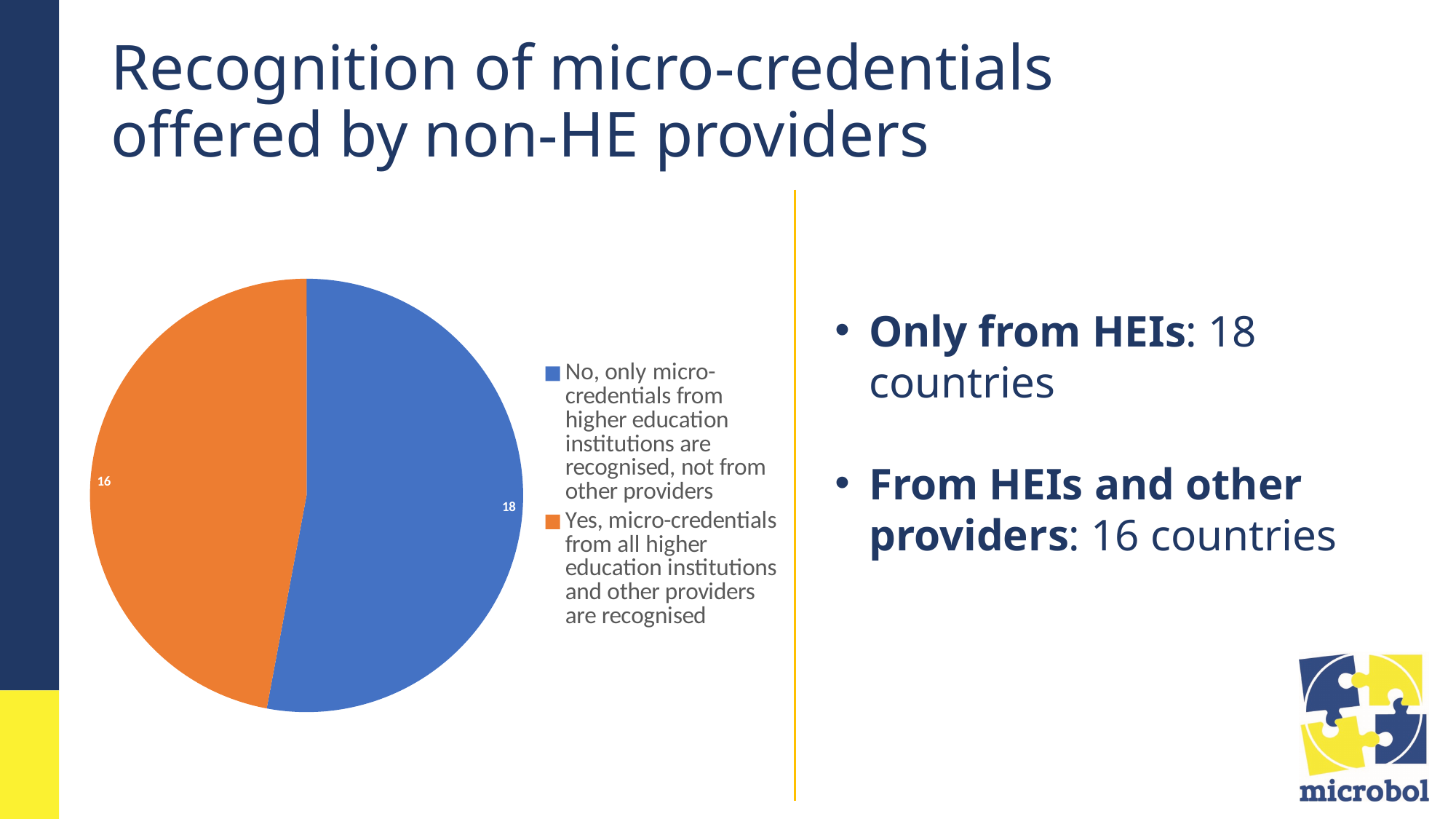
What type of chart is shown on the slide? pie chart How many slices does the pie chart have? 2 What is the value of the slice for 'Yes, micro-credentials from all higher education institutions and other providers are recognised'? 16 What is the total of the two slices in the pie chart? 34 How many entries does the pie chart legend list? 2 What colour is the slice for 'Yes, micro-credentials from all higher education institutions and other providers are recognised'? orange Which slice of the pie chart is the smallest? Yes, micro-credentials from all higher education institutions and other providers are recognised Which is larger: the 'No' slice or the 'Yes' slice? the 'No' slice Which slice of the pie chart is the largest? No, only micro-credentials from higher education institutions are recognised, not from other providers What is the difference between the 'No, only from higher education institutions' slice and the 'Yes, from all higher education institutions and other providers' slice? 2 What fraction of the pie total does the 'No, only micro-credentials from higher education institutions are recognised' slice represent? 18/34 What is the value of the slice for 'No, only micro-credentials from higher education institutions are recognised, not from other providers'? 18